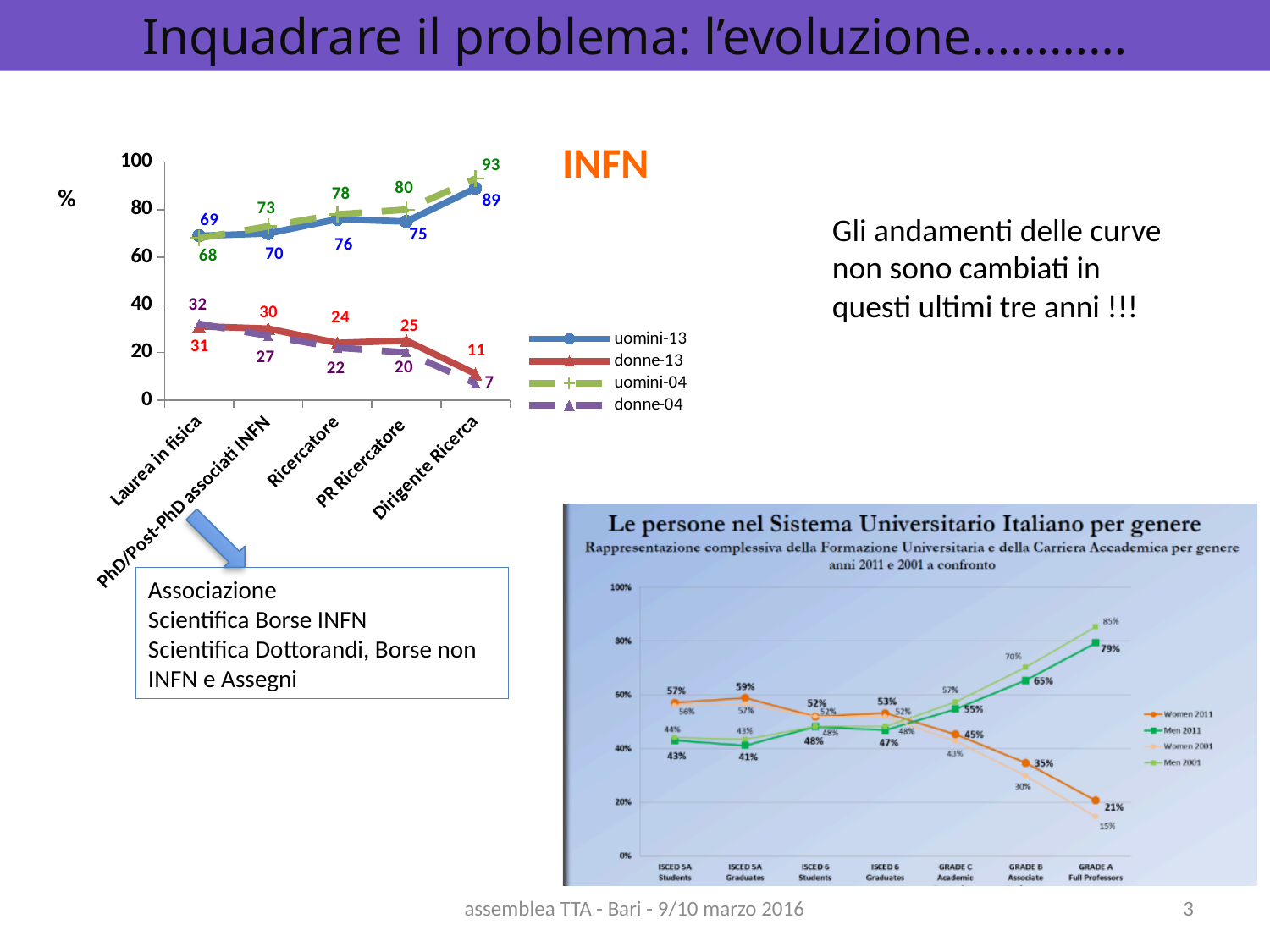
In the INFN chart, does the donne-13 series rise or fall from Laurea in fisica to Dirigente Ricerca? fall What kind of chart is the INFN chart? line chart In the INFN chart, what is the difference between uomini-04 and uomini-13 for Dirigente Ricerca? 4 In the INFN chart, how many categories are on the x axis? 5 In the chart 'Le persone nel Sistema Universitario Italiano per genere', which category has the highest value for Women 2011? ISCED 5A Graduates In the chart 'Le persone nel Sistema Universitario Italiano per genere', what is the value of Women 2011 for GRADE B Associate? 35% In the INFN chart, which category has the lowest value for donne-13? Dirigente Ricerca In the INFN chart, what is the value of donne-04 for Ricercatore? 22 In the INFN chart, how many series does the legend list? 4 In the INFN chart, which is larger: donne-13 for Laurea in fisica or donne-04 for Laurea in fisica? donne-04 for Laurea in fisica In the chart 'Le persone nel Sistema Universitario Italiano per genere', what is the value of Men 2011 for GRADE A Full Professors? 79% In the INFN chart, what is the value of uomini-13 for Dirigente Ricerca? 89